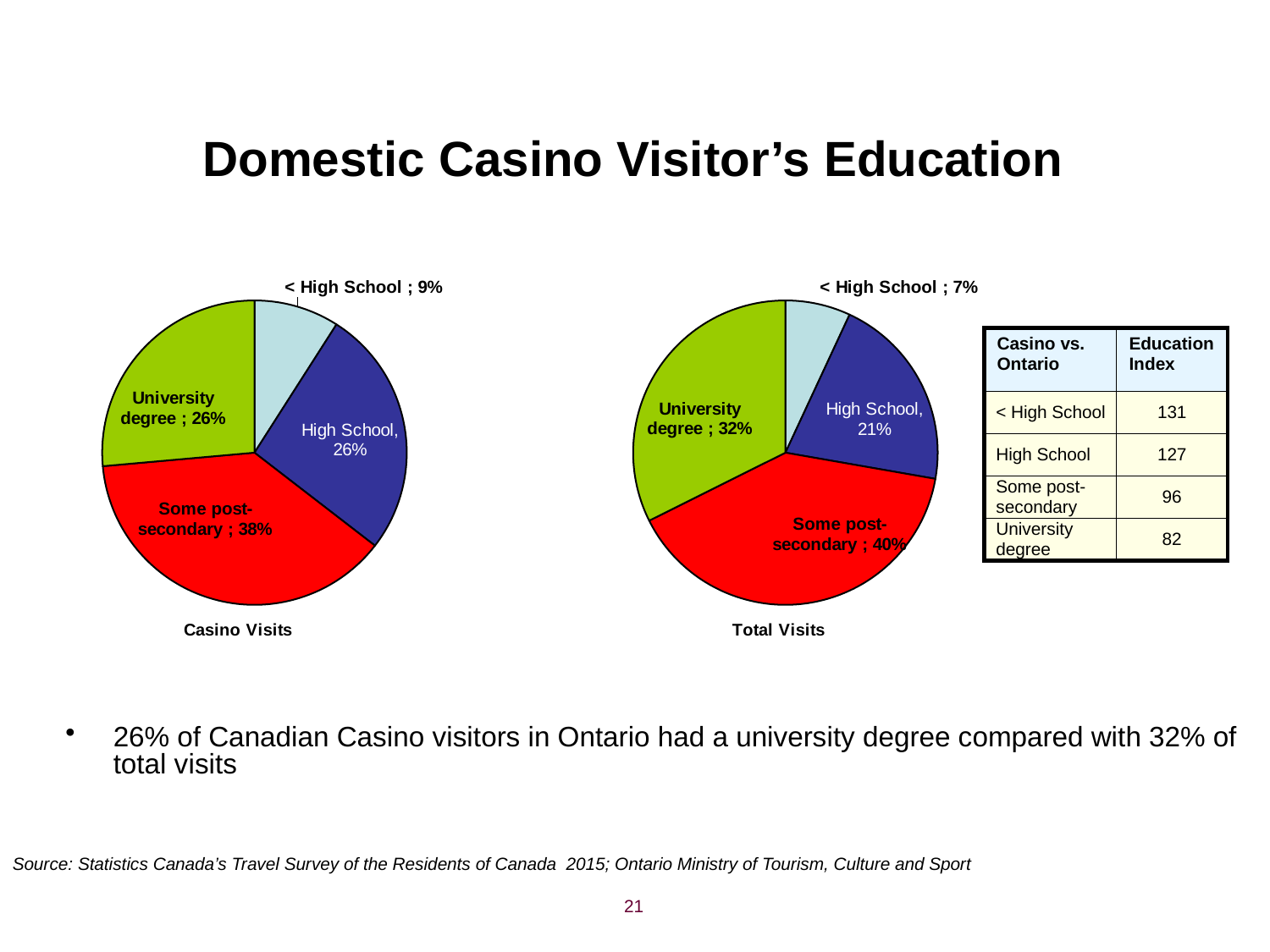
In the Casino Visits pie chart, what is the share for < High School? 9% In the Casino Visits pie chart, what share of visitors had some post-secondary education? 38% What is the difference between the University degree share in the Total Visits chart and in the Casino Visits chart? 6% In the Total Visits pie chart, which education category has the smallest share? < High School In the Casino Visits pie chart, which education category has the largest share? Some post-secondary Which is larger: the High School share in the Casino Visits chart or in the Total Visits chart? Casino Visits What type of chart is used for Casino Visits and Total Visits? Pie chart What is the difference between the Some post-secondary share in the Total Visits chart and in the Casino Visits chart? 2% In the Casino Visits pie chart, what colour is the Some post-secondary slice? Red How many slices does the Casino Visits pie chart have? 4 In the Total Visits pie chart, what share of visits were by people with a university degree? 32% In the Total Visits pie chart, what is the share for High School? 21%